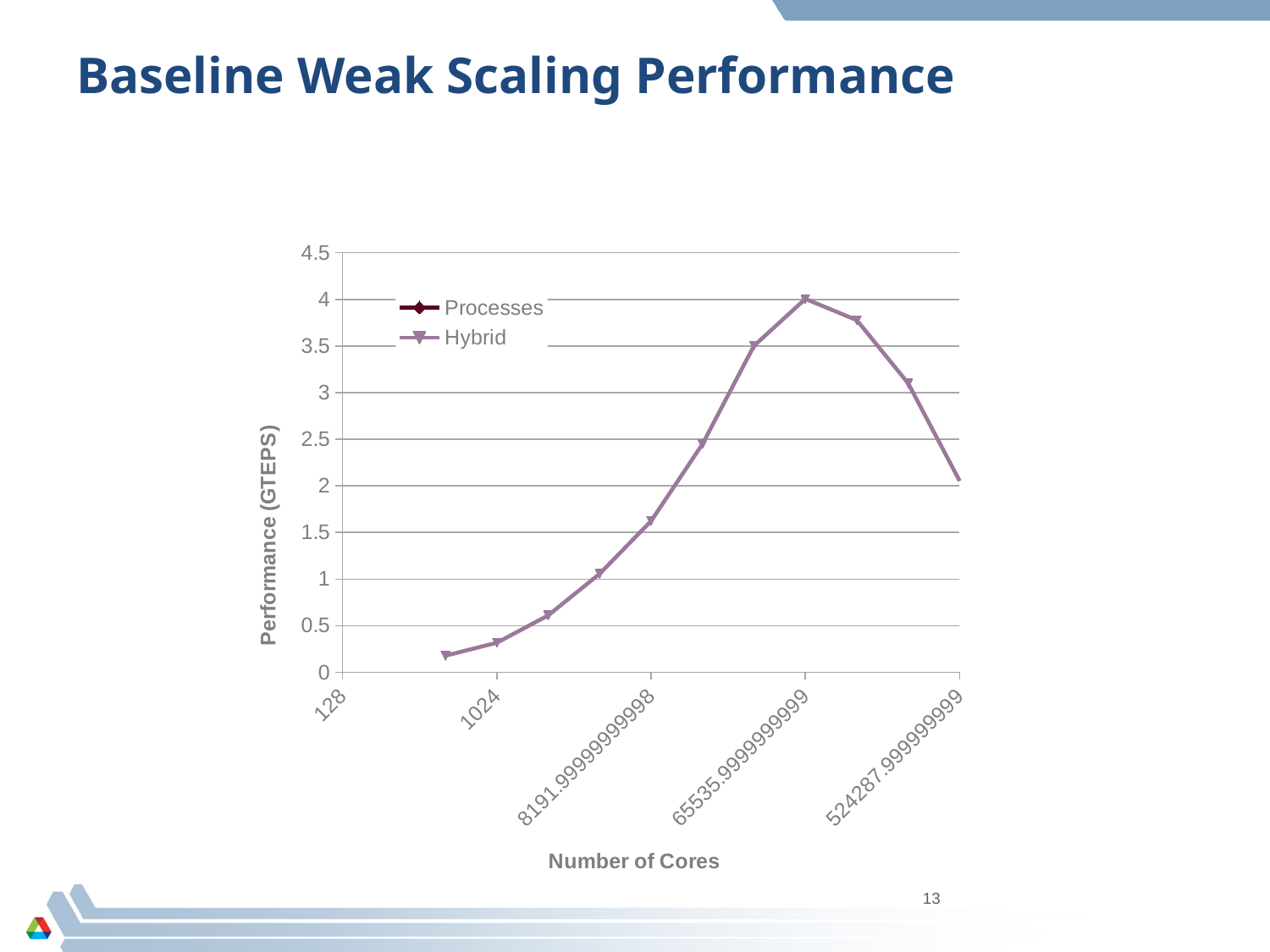
What kind of chart is shown on the slide? line chart At which labeled number of cores does the Hybrid line reach its highest value? 65535.9999999999 Is the Hybrid value at 524287.999999999 cores greater or less than 2.5? less What is the title of the y axis? Performance (GTEPS) How many series does the legend list? 2 What are the two series named in the legend? Processes and Hybrid Is the Hybrid value at 8191.99999999998 cores greater or less than 1? greater Is the Hybrid value at 65535.9999999999 cores greater or less than 3.5? greater Which has the larger Hybrid value: 8191.99999999998 cores or 524287.999999999 cores? 524287.999999999 How does the Hybrid line behave as the number of cores increases along the x axis? rises to a peak, then falls Which has the larger Hybrid value: 1024 cores or 65535.9999999999 cores? 65535.9999999999